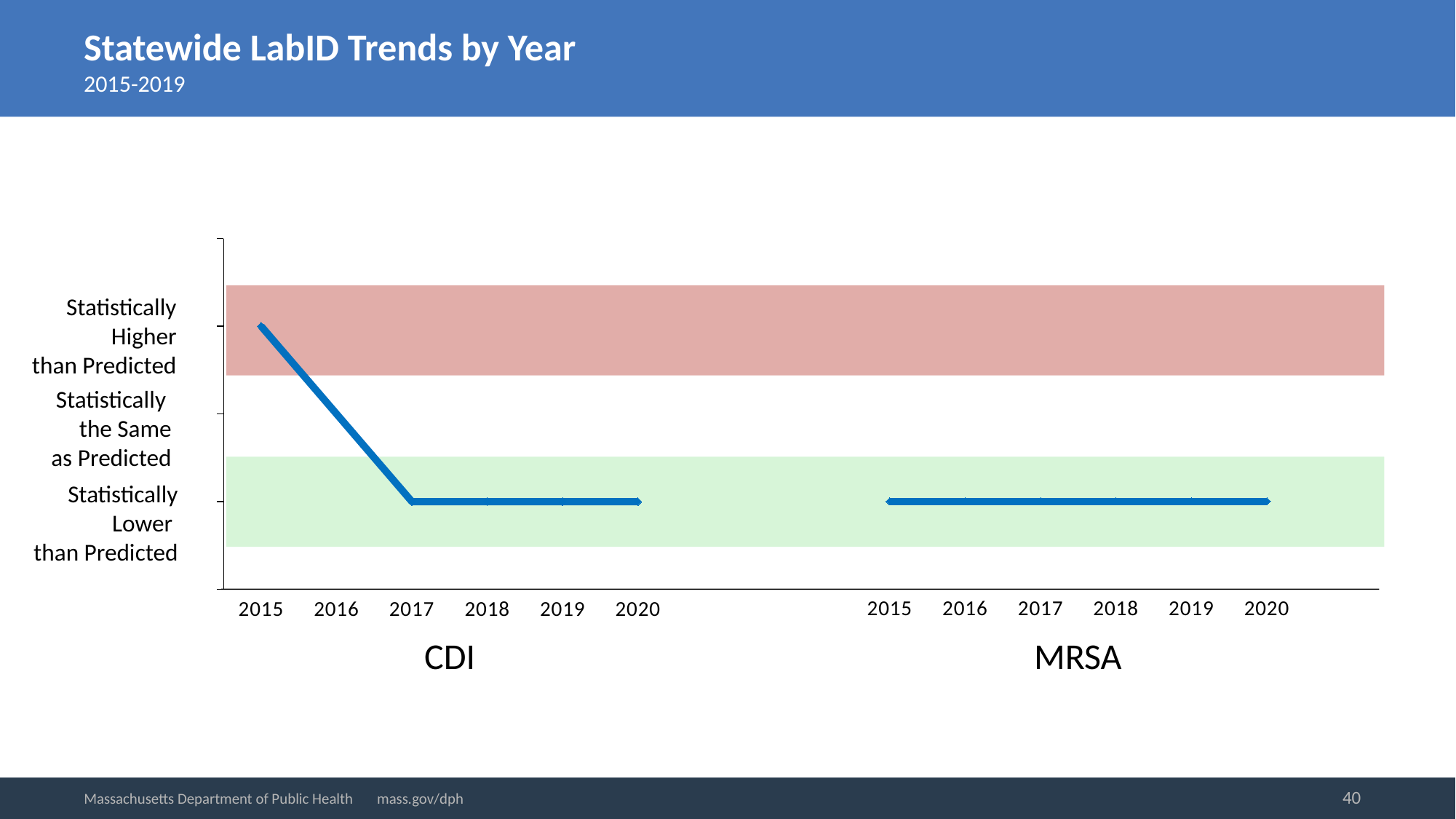
In the CDI chart, which category does the 2017 point fall in? Statistically Lower than Predicted In the MRSA chart, which category does the 2019 point fall in? Statistically Lower than Predicted What is the title of the slide's chart? Statewide LabID Trends by Year In the CDI chart, does the line rise or fall from 2015 to 2017? fall In the MRSA chart, does the line rise, fall, or stay flat from 2015 to 2020? stay flat What type of chart is shown on the slide? line chart In the CDI chart, which category does the 2020 point fall in? Statistically Lower than Predicted In the CDI chart, which year has the highest point? 2015 In the CDI chart, which category does the 2015 point fall in? Statistically Higher than Predicted Which two infections are compared in the charts on the slide? CDI and MRSA How many years are shown on the x axis of the CDI chart? 6 In the MRSA chart, which category does the 2015 point fall in? Statistically Lower than Predicted